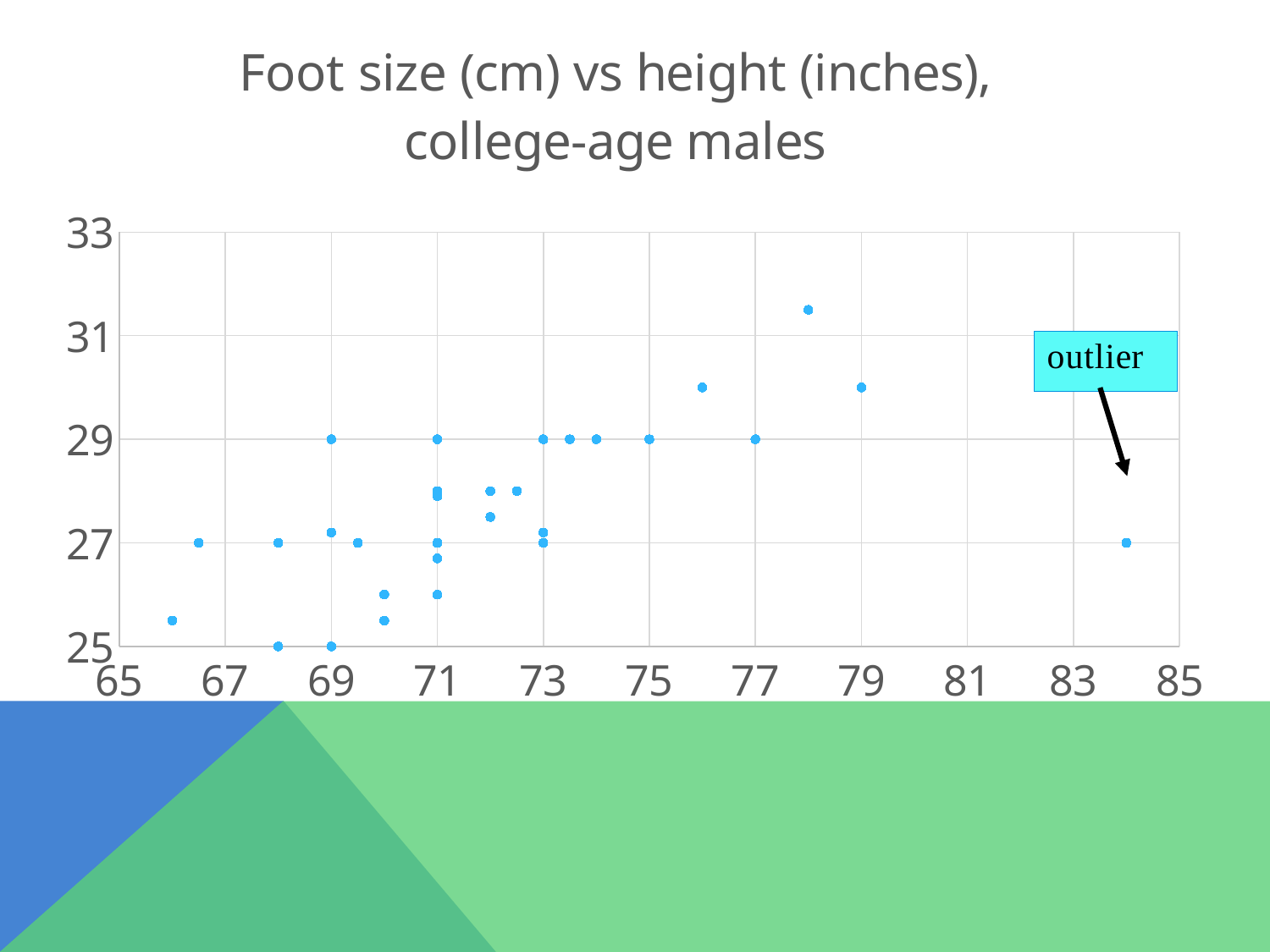
What is the highest value shown on the y axis? 33 What kind of chart is shown on the slide? scatter plot Ignoring the outlier, do foot sizes generally rise or fall as height increases along the x axis? rise Is the height of the point with the largest foot size greater or less than 77? greater Is the foot size of the leftmost point (at a height of about 66) greater or less than 27? less Is the foot size of the point labelled as the outlier greater or less than 29? less What is the title of the chart? Foot size (cm) vs height (inches), college-age males What does the text box annotation on the chart label the point at the far right as? outlier